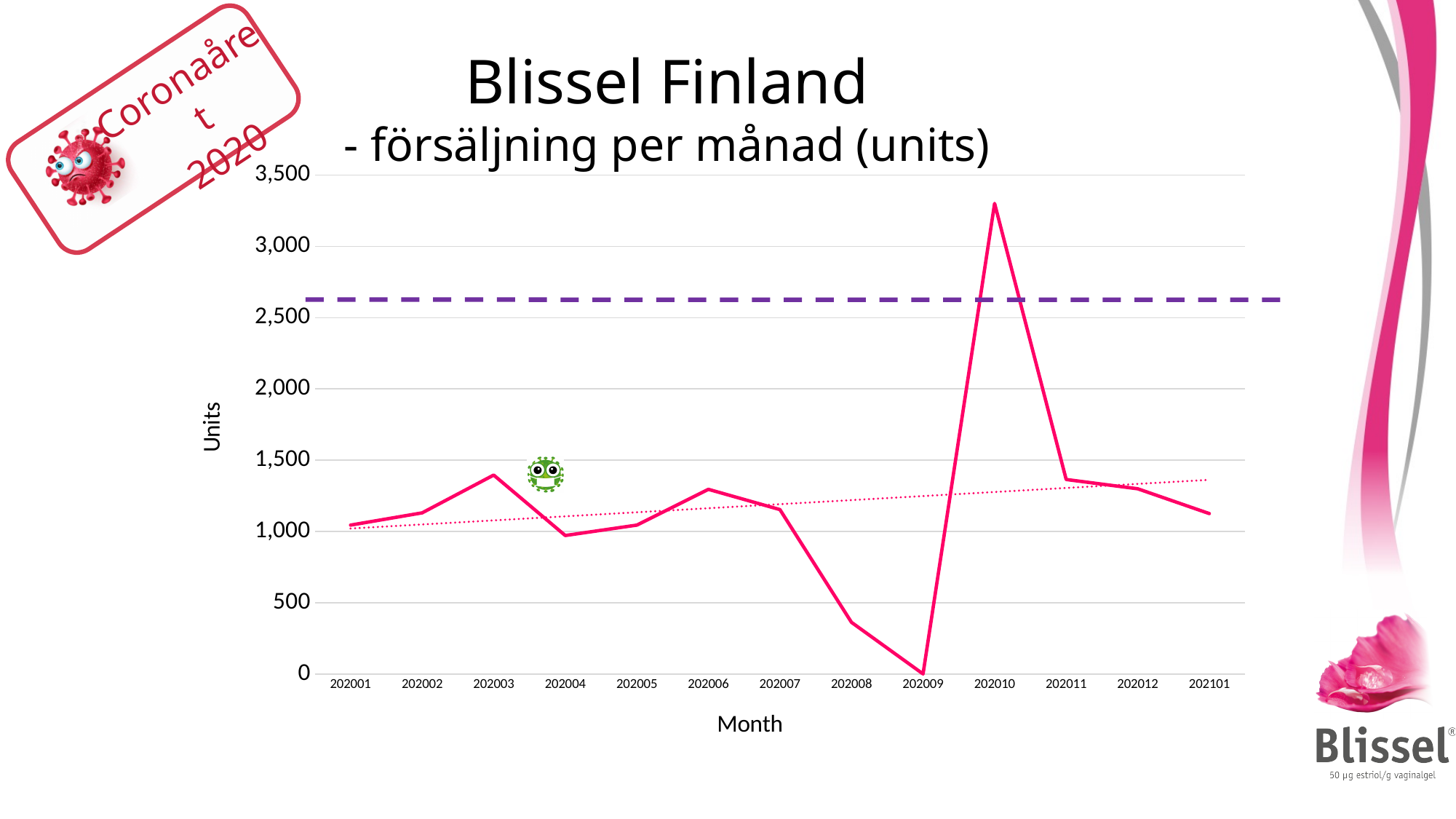
Which month has the larger value, 202001 or 202008? 202001 What kind of chart is shown on the slide? line chart Is the value for 202006 greater or less than 1,000? greater What is the label of the x axis? Month How many months are plotted on the x axis? 13 Is the value for 202003 greater or less than 1,500? less Is the value for 202008 greater or less than 500? less Do the values rise or fall from 202007 to 202009? fall Which month has the larger value, 202010 or 202003? 202010 Which month has the highest number of units sold? 202010 Which month has the lowest number of units sold? 202009